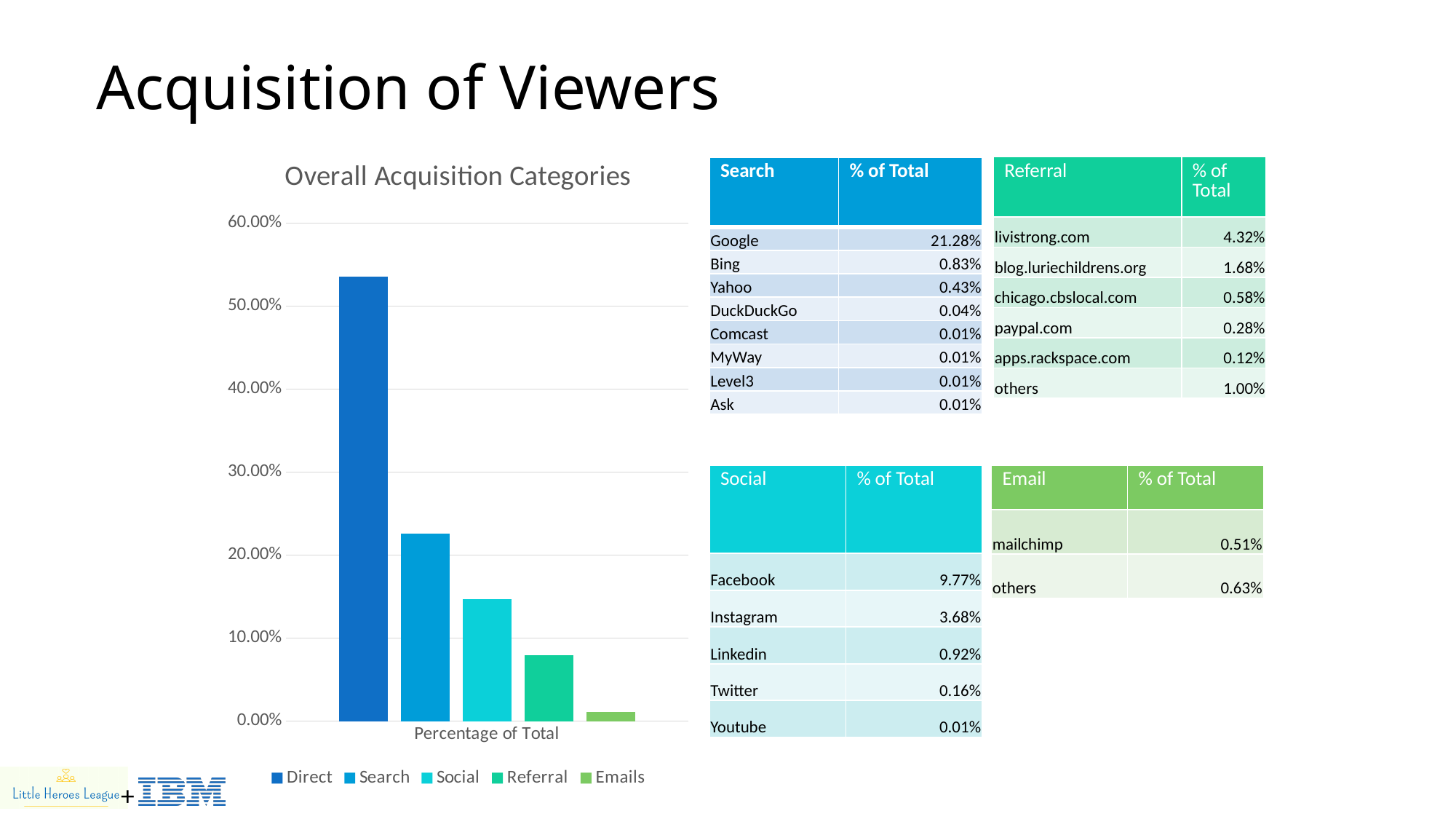
How many series does the legend of the "Overall Acquisition Categories" chart list? 5 What kind of chart is shown under the title "Overall Acquisition Categories"? bar chart In the "Overall Acquisition Categories" chart, is the value for Search greater or less than 20.00%? greater Which series has the lowest value in the "Overall Acquisition Categories" chart? Emails In the "Overall Acquisition Categories" chart, is the value for Direct greater or less than 50.00%? greater In the "Overall Acquisition Categories" chart, is the value for Referral greater or less than 10.00%? less In the "Overall Acquisition Categories" chart, which is larger, Referral or Emails? Referral What is the title of the chart on the slide? Overall Acquisition Categories Which series has the highest value in the "Overall Acquisition Categories" chart? Direct In the "Overall Acquisition Categories" chart, which is larger, Search or Social? Search What is the x-axis label of the "Overall Acquisition Categories" chart? Percentage of Total